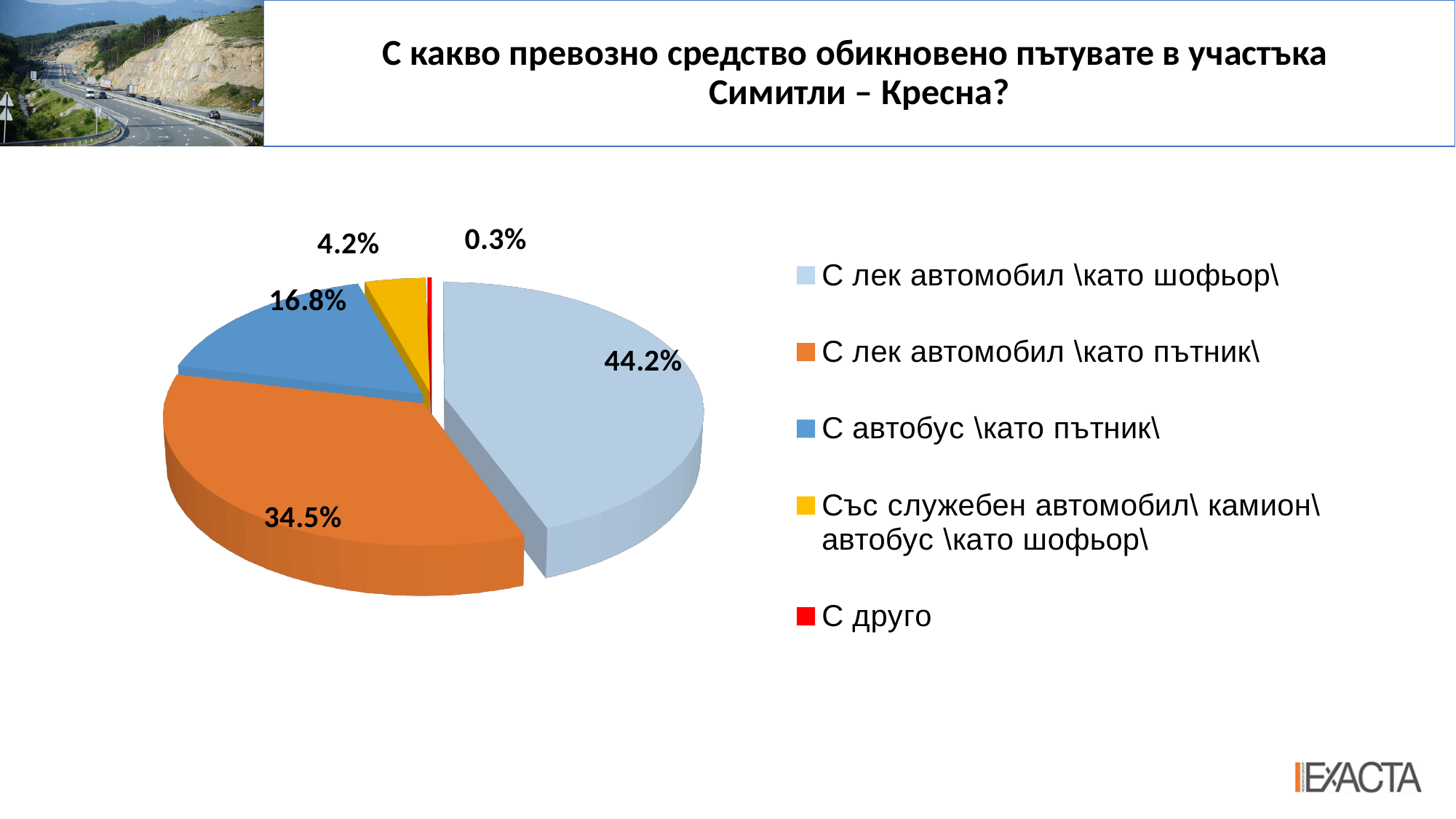
How many categories does the pie chart have? 5 Which category has the largest share of the pie? С лек автомобил \като шофьор\ What colour is the slice for "С друго"? red What share of respondents travel "С лек автомобил \като пътник\"? 34.5% What share of respondents answered "С друго"? 0.3% What share of respondents travel "Със служебен автомобил\ камион\ автобус \като шофьор\"? 4.2% What is the difference between the shares for "С лек автомобил \като шофьор\" and "С лек автомобил \като пътник\"? 9.7% What share of respondents travel "С лек автомобил \като шофьор\"? 44.2% Which category has the smallest share of the pie? С друго What kind of chart is shown on the slide? pie chart What share of respondents travel "С автобус \като пътник\"? 16.8% Which is larger: the share for "С автобус \като пътник\" or the share for "Със служебен автомобил\ камион\ автобус \като шофьор\"? С автобус \като пътник\